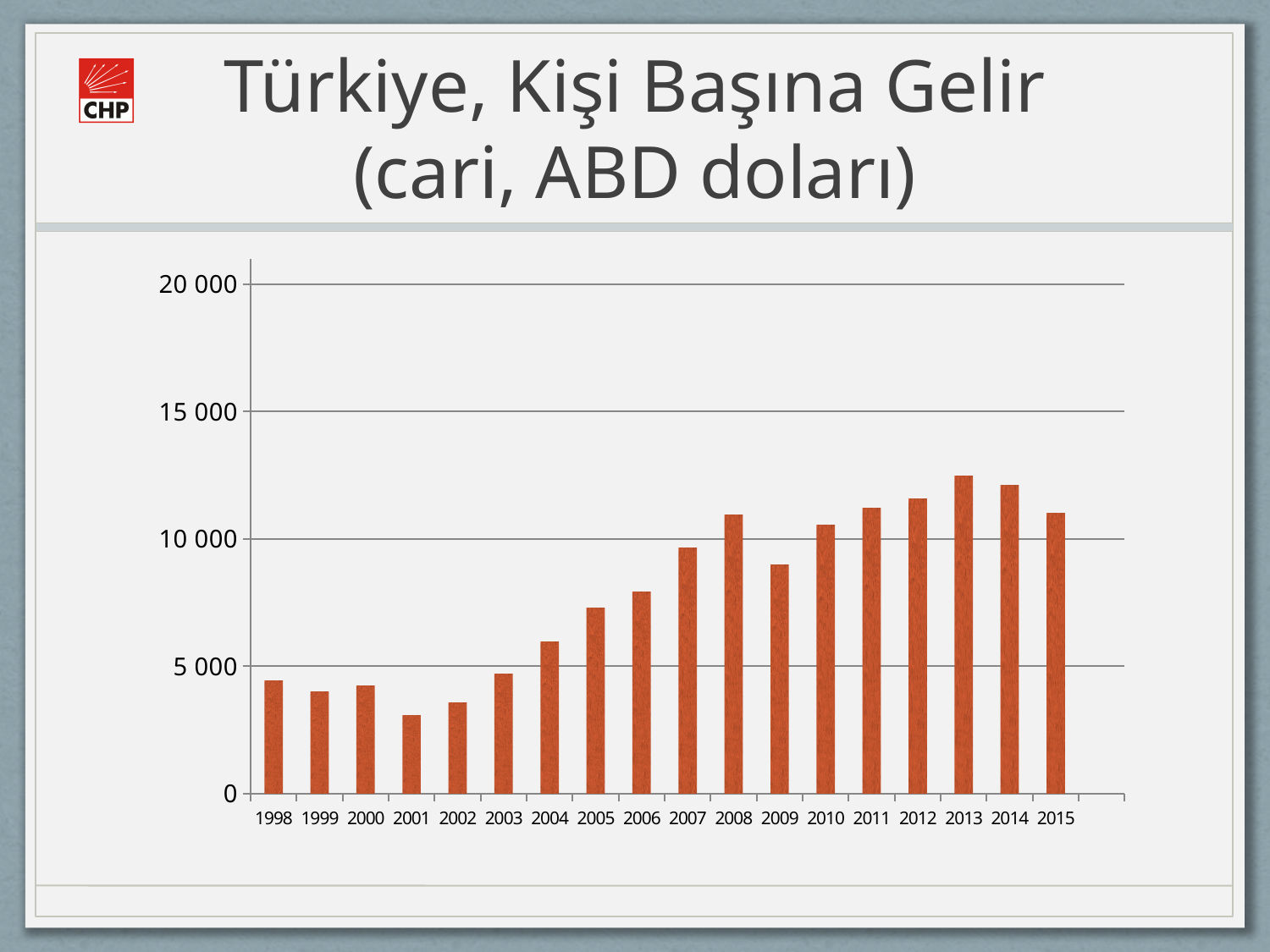
Is the value for 2013 greater or less than 10 000? greater Which year has the highest bar in the chart? 2013 Is the value for 2001 greater or less than 5 000? less Which year has the larger value, 2008 or 2009? 2008 Do the values generally rise or fall from 2001 to 2008? rise What kind of chart is shown on the slide? bar chart How many years are plotted on the x axis? 18 Is the value for 2009 greater or less than 10 000? less Which year has the lowest bar in the chart? 2001 What is the title of the chart on the slide? Türkiye, Kişi Başına Gelir (cari, ABD doları)